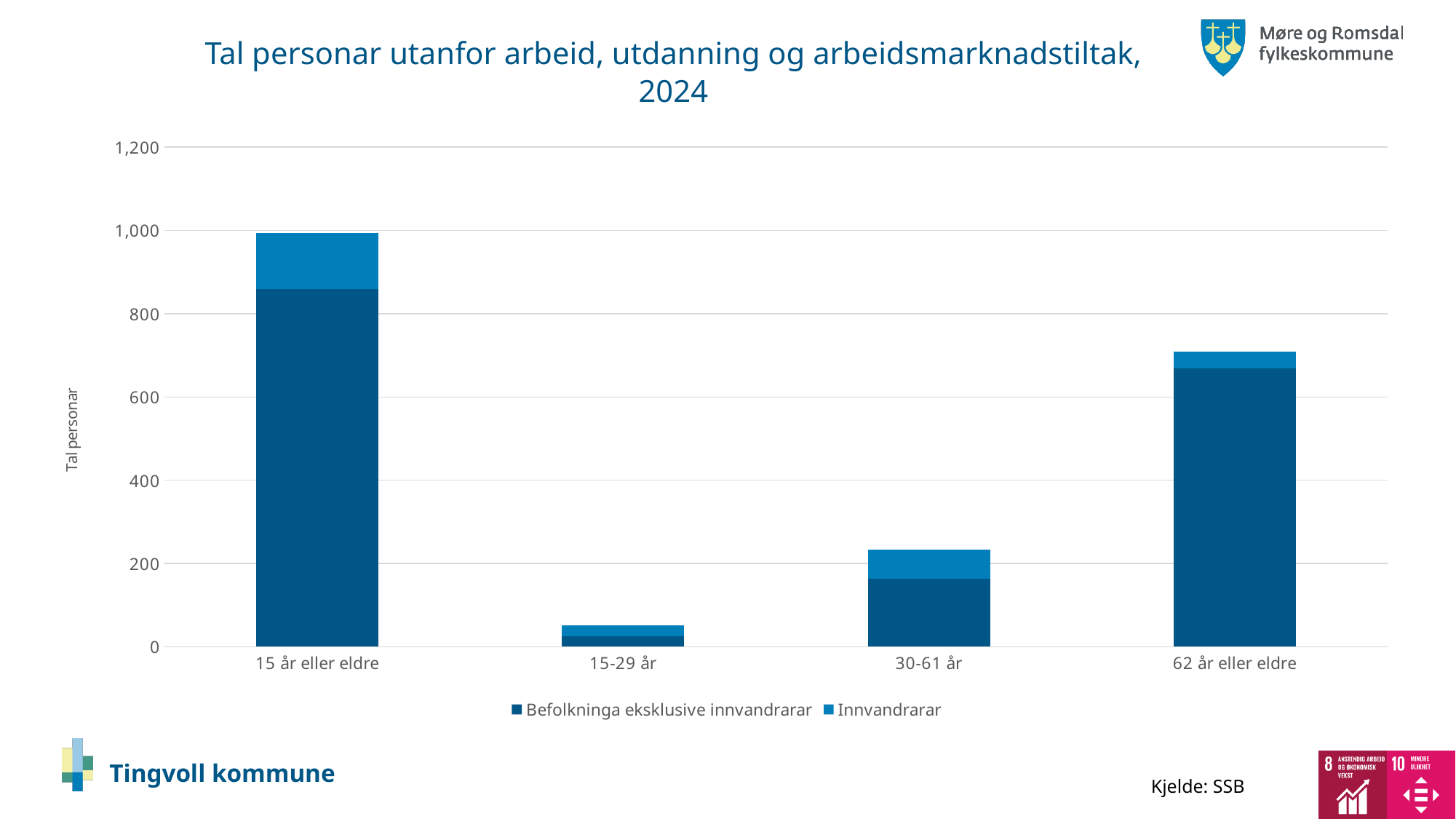
What is the title of the chart? Tal personar utanfor arbeid, utdanning og arbeidsmarknadstiltak, 2024 Is the total stacked bar for 62 år eller eldre greater or less than 600? greater What is the label on the y axis? Tal personar Which category has the shortest stacked bar? 15-29 år What kind of chart is shown on the slide? Stacked bar chart How many series does the legend list? 2 Is the total stacked bar for 15-29 år greater or less than 200? less Is the total stacked bar for 62 år eller eldre greater or less than 800? less Which category has the tallest stacked bar? 15 år eller eldre Which has the larger total stacked bar, 30-61 år or 62 år eller eldre? 62 år eller eldre How many age categories are shown on the x axis? 4